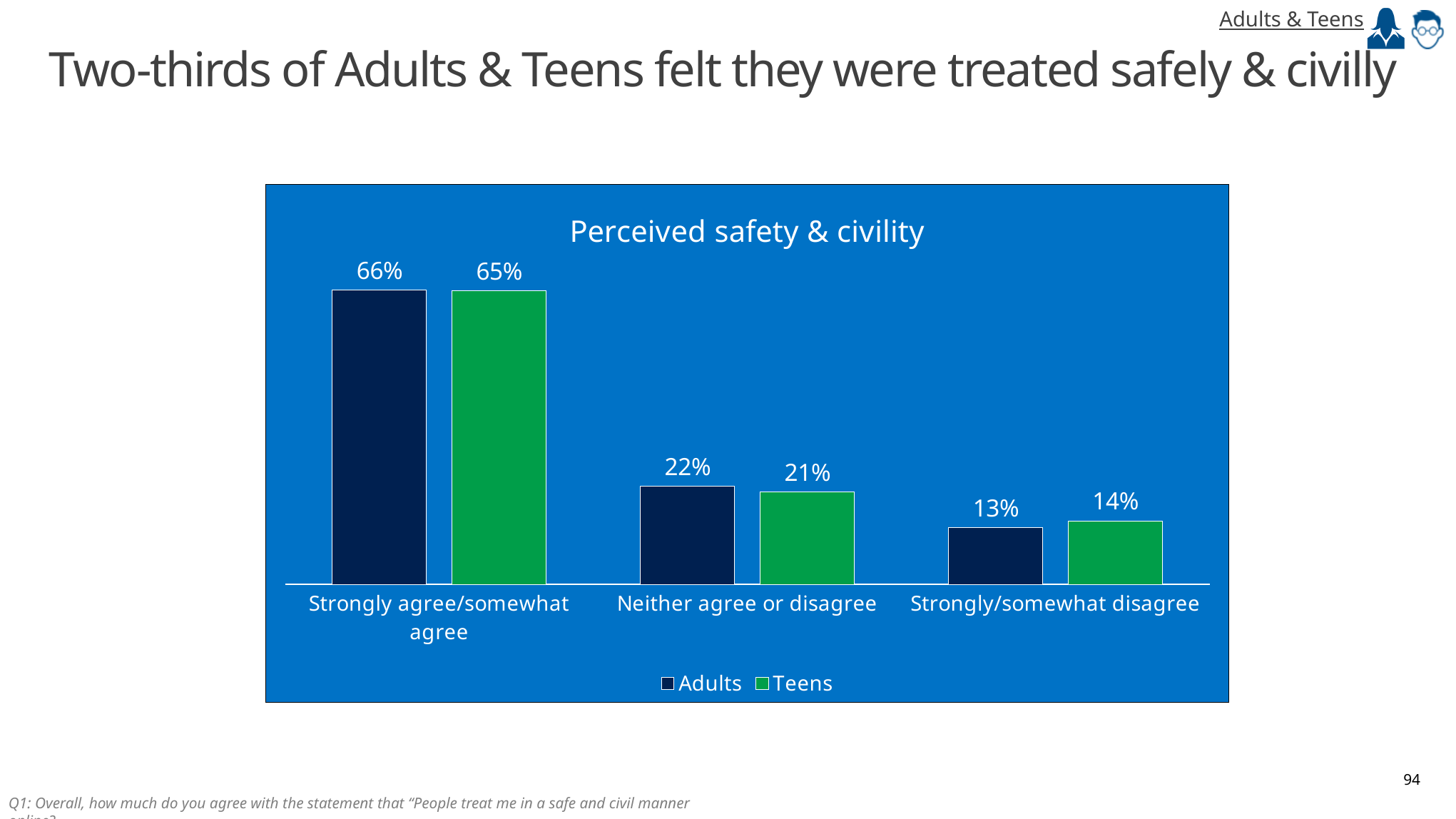
What kind of chart is shown on the slide? Bar chart What is the value for Teens in the 'Strongly/somewhat disagree' category? 14% How many series does the legend list? 2 What is the value for Teens in the 'Neither agree or disagree' category? 21% How many categories are shown on the x axis? 3 Which category has the lowest value for Adults? Strongly/somewhat disagree What is the title of the chart? Perceived safety & civility What is the value for Adults in the 'Strongly agree/somewhat agree' category? 66% Which category has the highest value for Teens? Strongly agree/somewhat agree What is the difference between the Adults and Teens values in the 'Neither agree or disagree' category? 1% What is the difference between the Adults values for 'Strongly agree/somewhat agree' and 'Neither agree or disagree'? 44% What is the value for Adults in the 'Strongly/somewhat disagree' category? 13%